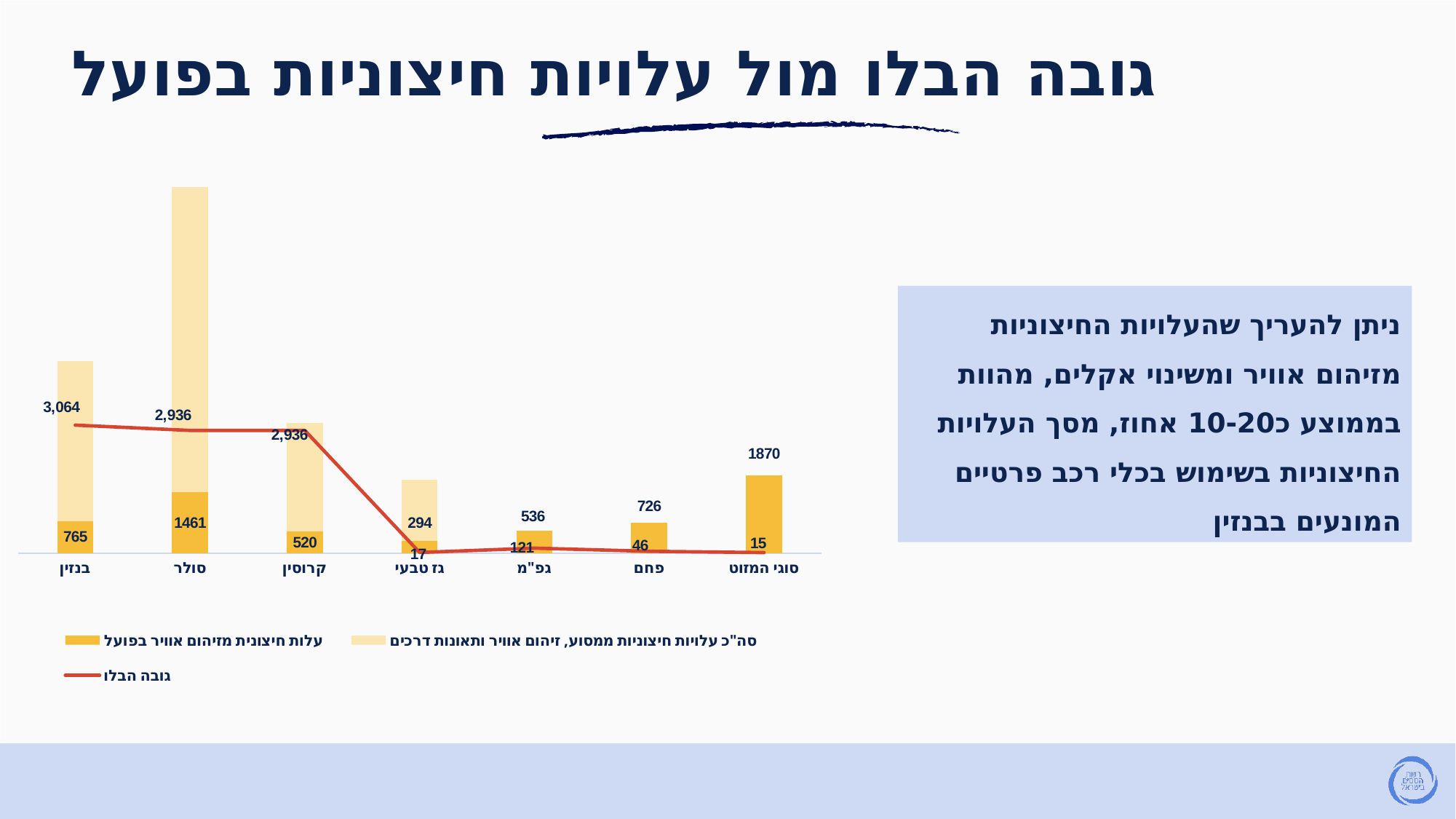
What is the difference between the עלות חיצונית מזיהום אוויר בפועל values for סולר and קרוסין? 941 Which category has the lowest value of גובה הבלו? סוגי המזוט What is the value of גובה הבלו for בנזין? 3,064 Which has a higher גובה הבלו value, גפ"מ or פחם? גפ"מ Does the גובה הבלו line generally rise or fall from בנזין on the left to סוגי המזוט on the right? fall What kind of chart is shown on the slide? bar chart with a line Which category has the lowest value of עלות חיצונית מזיהום אוויר בפועל? גז טבעי What is the value of עלות חיצונית מזיהום אוויר בפועל for סולר? 1461 How many fuel categories are shown on the x axis of the chart? 7 How many series does the chart legend list? 3 Which category has the highest value of עלות חיצונית מזיהום אוויר בפועל? סוגי המזוט What is the value of גובה הבלו for סוגי המזוט? 15